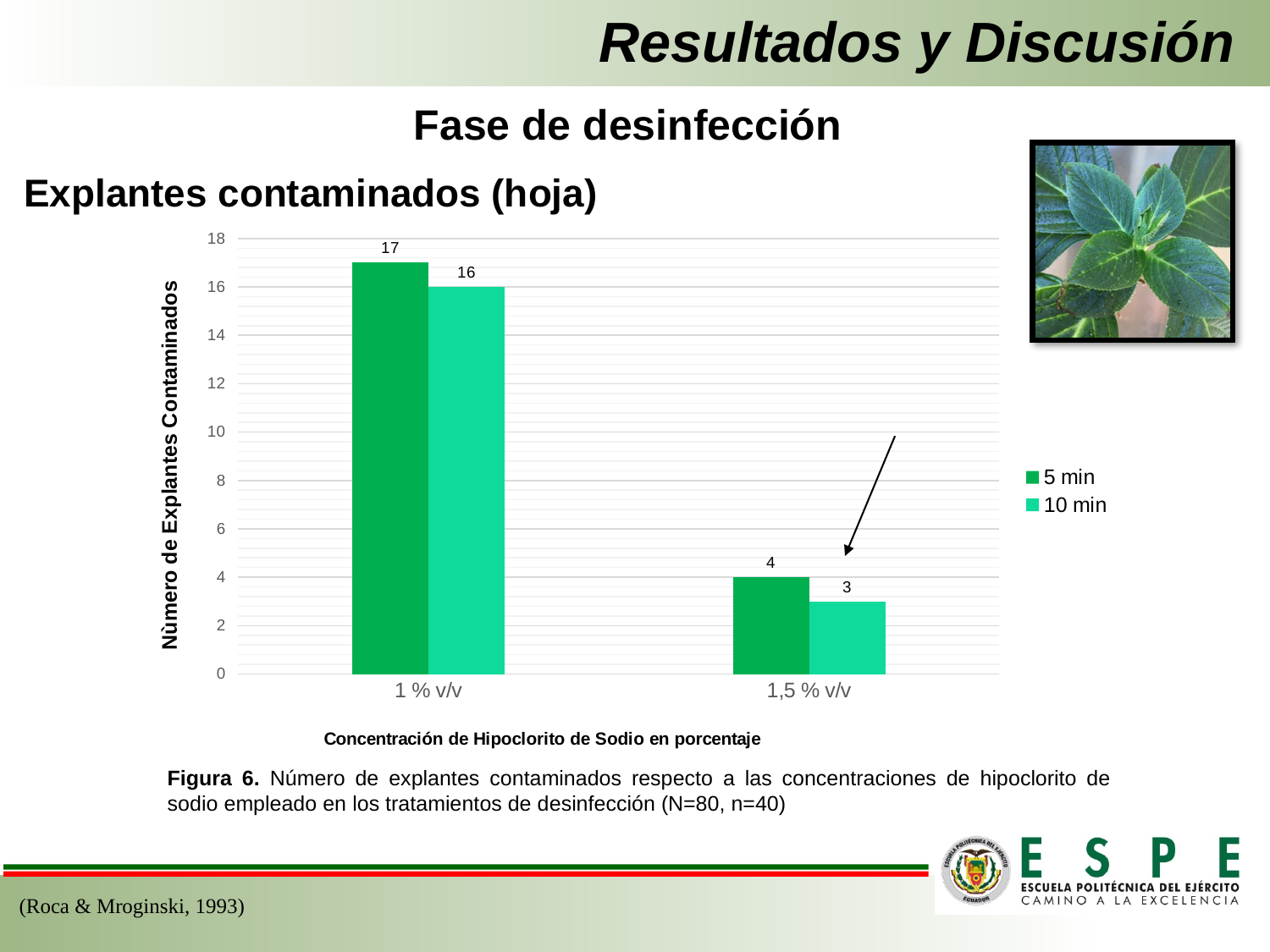
Which concentration has the highest number of contaminated explants for the 5 min series? 1 % v/v How many series does the legend list? 2 What kind of chart is shown on the slide? Bar chart Which concentration has the lowest number of contaminated explants for the 10 min series? 1,5 % v/v Which is larger at 1 % v/v: the 5 min value or the 10 min value? 5 min What is the number of contaminated explants for 5 min at 1 % v/v? 17 What is the label of the y axis? Nùmero de Explantes Contaminados What is the number of contaminated explants for 10 min at 1,5 % v/v? 3 What is the number of contaminated explants for 5 min at 1,5 % v/v? 4 What is the number of contaminated explants for 10 min at 1 % v/v? 16 How many concentration categories are shown on the x axis? 2 What is the difference between the 5 min values at 1 % v/v and 1,5 % v/v? 13